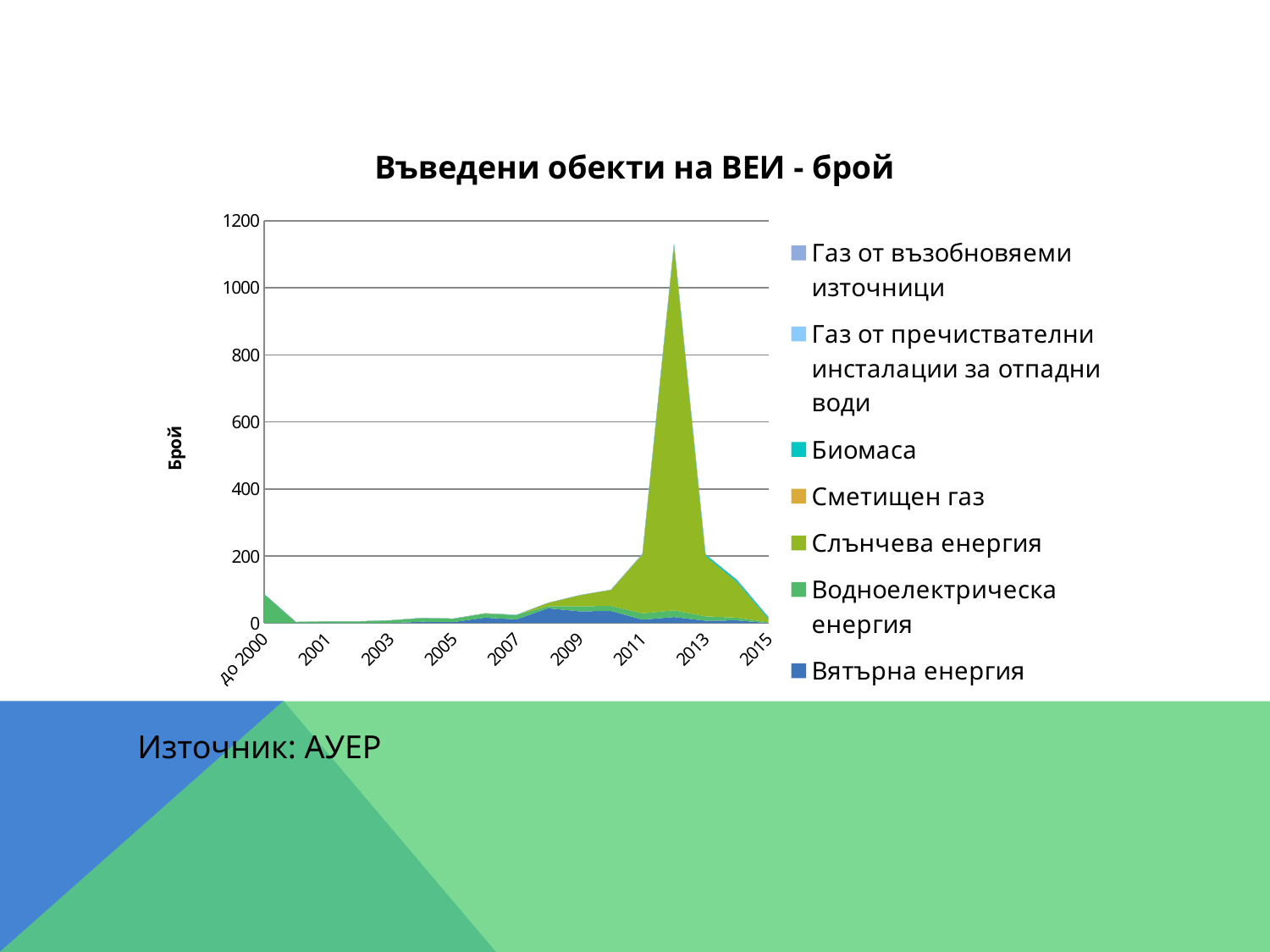
Is the stacked total for 2009 greater or less than 200? less What is the title of the chart? Въведени обекти на ВЕИ - брой Which series is shown at the bottom of the stack (dark blue)? Вятърна енергия What is the label of the vertical axis? Брой How many series does the legend list? 7 What kind of chart is shown on the slide? Stacked area chart Which series accounts for almost all of the large peak between 2011 and 2013? Слънчева енергия Is the stacked total for 2003 greater or less than 200? less Do the stacked totals rise or fall from 2013 to 2015? fall Is the stacked total for 2015 greater or less than 200? less Do the stacked totals rise or fall from 2005 to 2011? rise